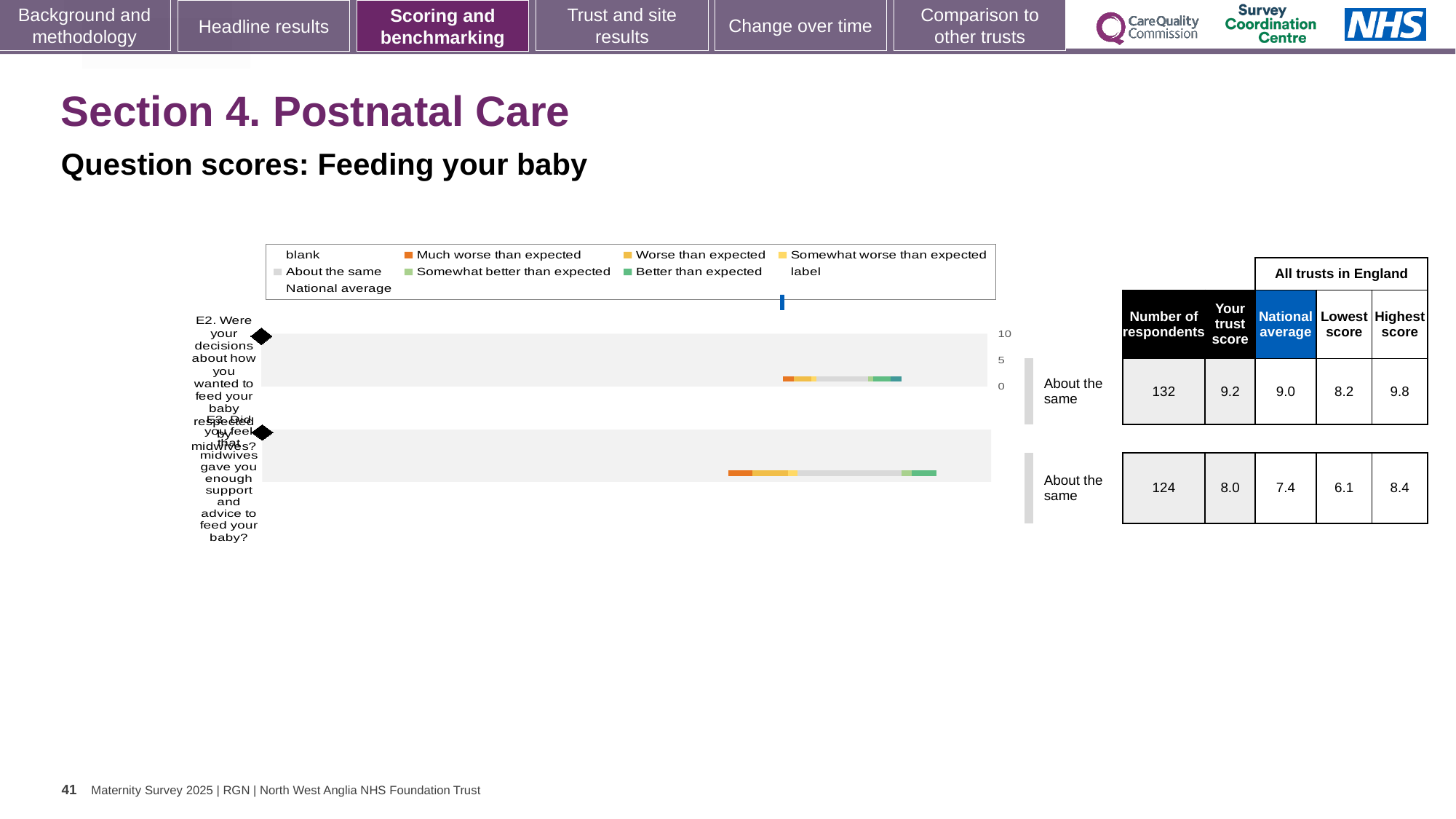
Which legend entry is shown in orange? Much worse than expected What is the highest score across all trusts in England for question E2? 9.8 What is the lowest score across all trusts in England for question E3? 6.1 How many respondents answered question E2? 132 What is the difference between the national averages for E2 and E3? 1.6 What is the trust score for question E2 about decisions on how you wanted to feed your baby being respected by midwives? 9.2 What is the difference between the trust scores for E2 and E3? 1.2 How many questions (categories) are plotted in the chart? 2 What is the trust score for question E3 about midwives giving enough support and advice to feed your baby? 8.0 What is the national average for question E3? 7.4 Which question has the higher trust score, E2 or E3? E2 What kind of chart is shown on the slide? bar chart